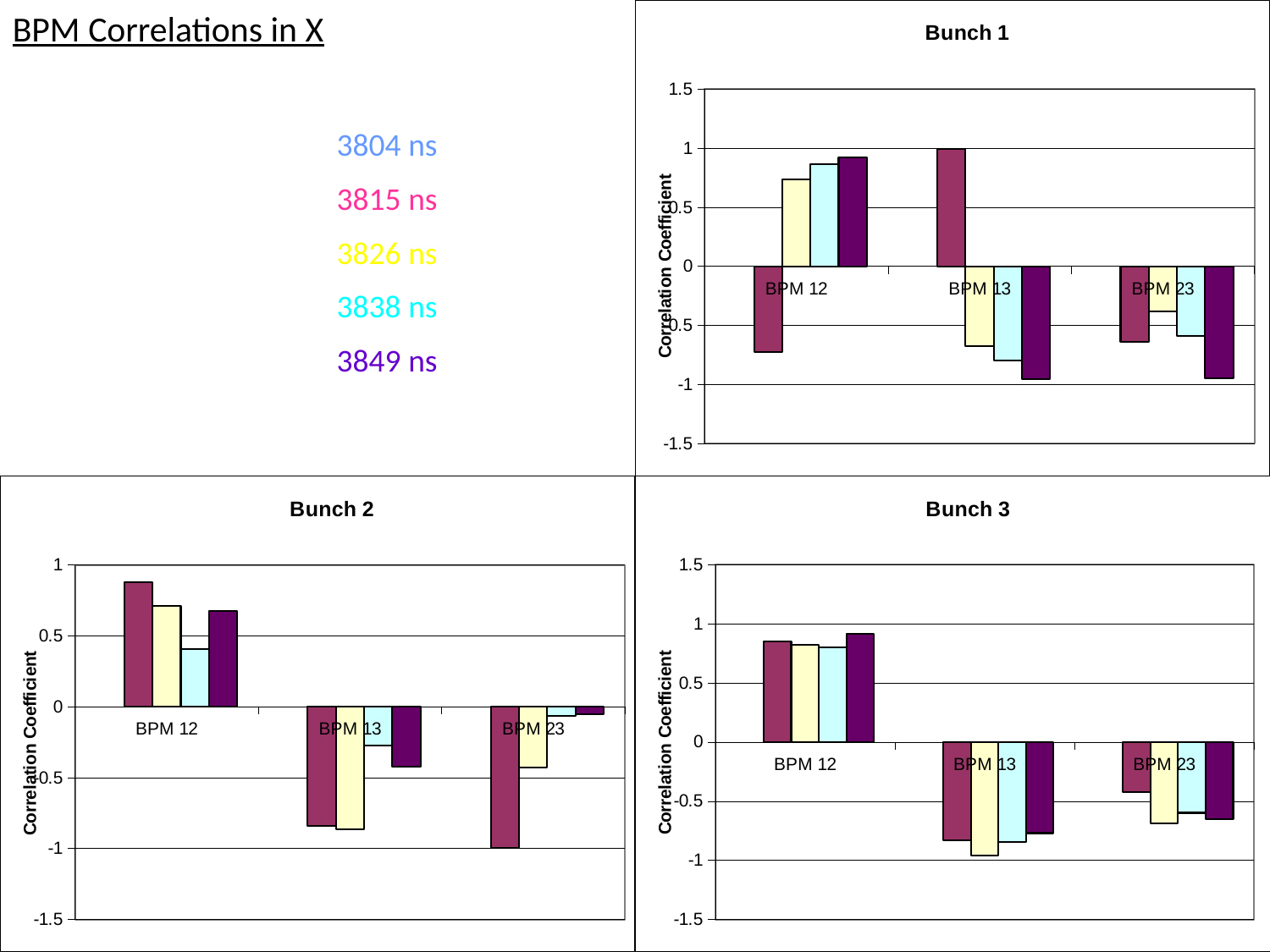
In the Bunch 2 chart, which bar for BPM 12 has the larger value: the first (maroon) bar or the third (light blue) bar? the first (maroon) bar What is the highest tick value shown on the y axis of the Bunch 2 chart? 1 What is the y-axis title of the Bunch 3 chart? Correlation Coefficient In the Bunch 2 chart, is the value of the first (maroon) bar for BPM 23 greater or less than -0.5? less How many charts are shown on the slide? 3 In the Bunch 1 chart, is the value of the first (maroon) bar for BPM 13 greater or less than 0.5? greater In the Bunch 3 chart, which bar for BPM 23 has the larger value: the first (maroon) bar or the second (light yellow) bar? the first (maroon) bar In the Bunch 1 chart, is the value of the last (purple) bar for BPM 23 greater or less than -0.5? less What kind of chart is the Bunch 1 chart? bar chart How many bars are plotted for the BPM 12 category in the Bunch 3 chart? 4 How many BPM categories are shown on the x axis of the Bunch 2 chart? 3